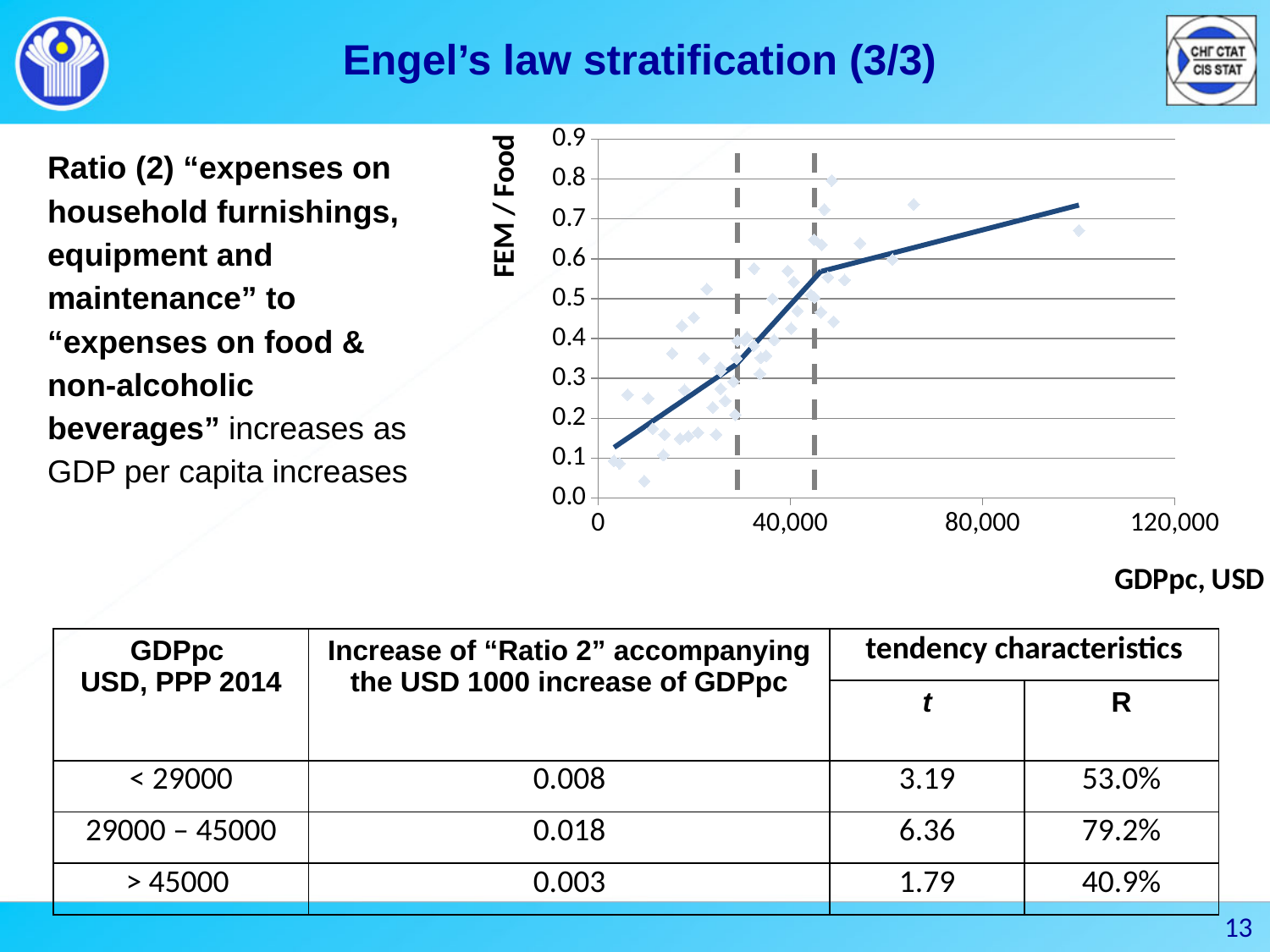
Is the value of the trend line at its leftmost point (near GDPpc 0) greater or less than 0.2? less Does the trend line in the chart rise or fall as GDPpc increases along the x axis? rises Is the value of the trend line at a GDPpc of 80,000 greater or less than 0.6? greater Is the value of the trend line at a GDPpc of 20,000 greater or less than 0.4? less What is the label of the horizontal axis of the chart? GDPpc, USD What kind of chart is shown on the slide? scatter chart What is the label of the vertical axis of the chart? FEM / Food